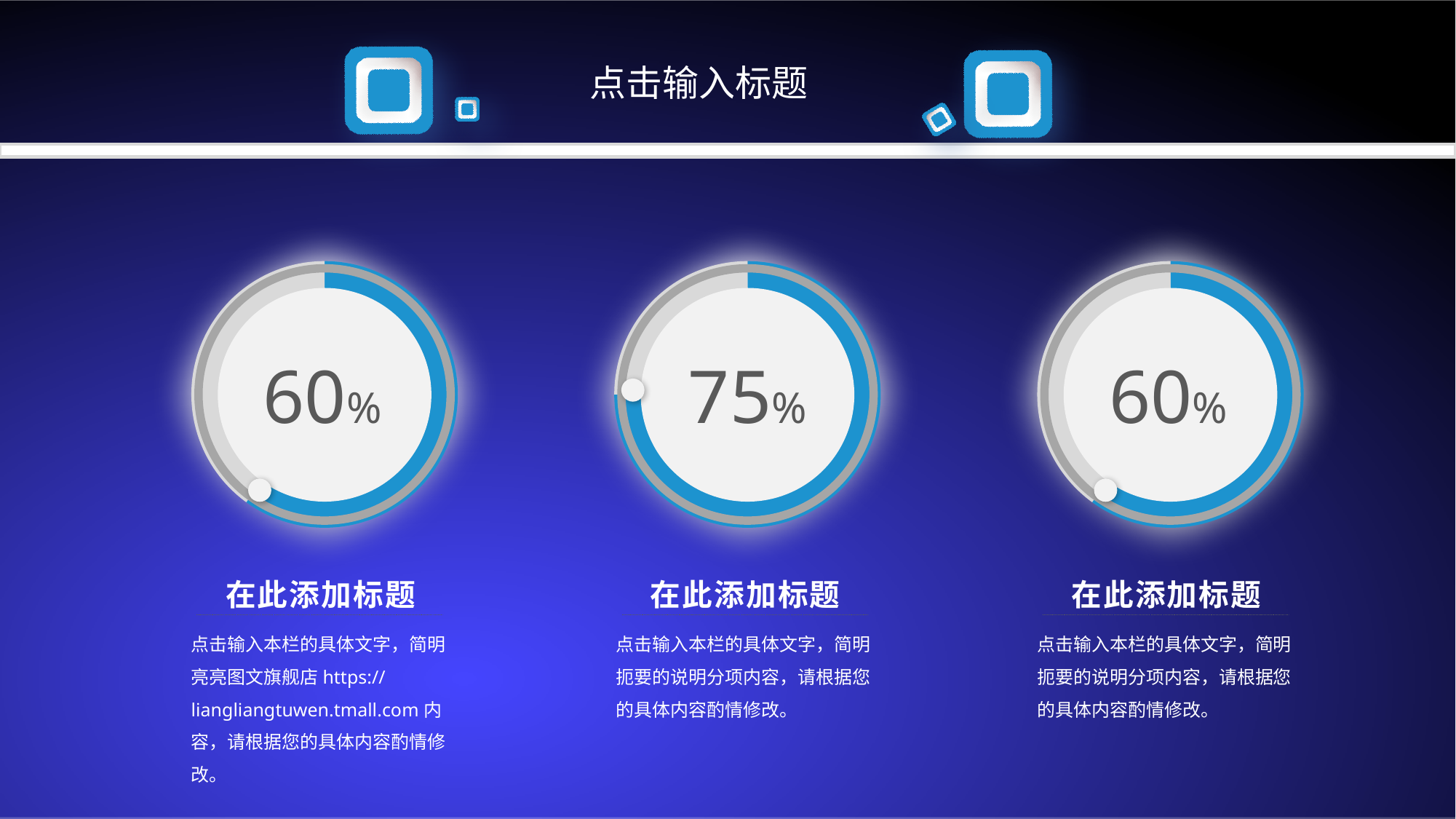
Which of the three circular charts shows the highest percentage? The middle chart What is the difference between the middle chart's value and the right chart's value? 15 percentage points What value is shown in the right circular chart? 60% Is the value in the middle chart larger or smaller than the value in the left chart? Larger What kind of chart is used to display the percentages on this slide? Circular progress (doughnut) charts Do the left and right circular charts show the same value? Yes, both show 60% What value is shown in the middle circular chart? 75% How many circular progress charts are on the slide? 3 What is the title text at the top of the slide? 点击输入标题 What value is shown in the left circular chart? 60% What colour is the filled arc in each circular chart? Blue